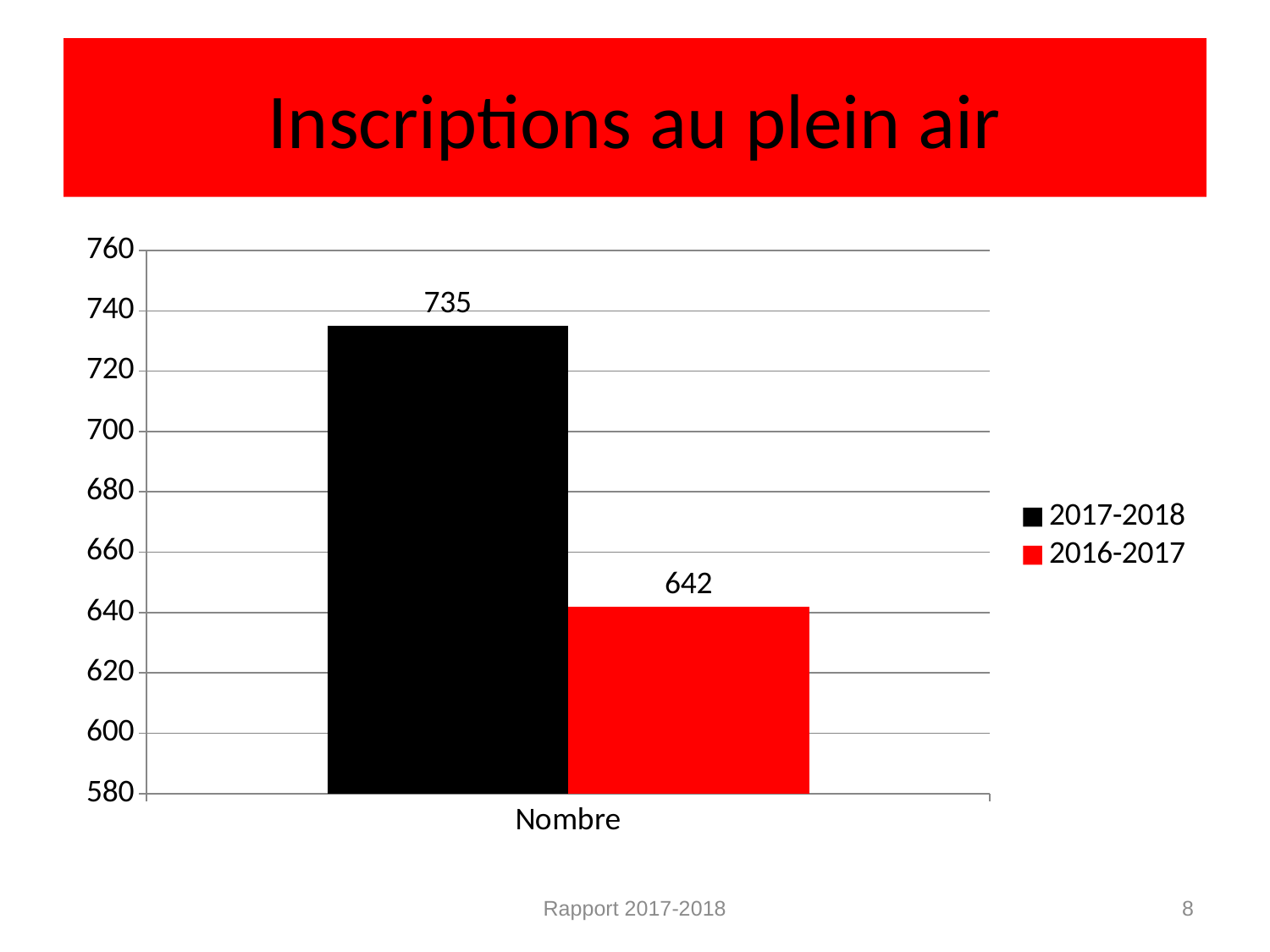
How many series does the legend list? 2 Which series has the higher value, 2017-2018 or 2016-2017? 2017-2018 Which series has the lower value? 2016-2017 What is the difference between the 2017-2018 value and the 2016-2017 value? 93 What is the value for 2017-2018? 735 Is the value for 2016-2017 larger or smaller than the value for 2017-2018? smaller What is the value for 2016-2017? 642 What is the title of the slide? Inscriptions au plein air Is the value for 2017-2018 greater or less than 720? greater Is the value for 2016-2017 greater or less than 660? less What colour is the bar for 2016-2017? red What kind of chart is shown on the slide? bar chart